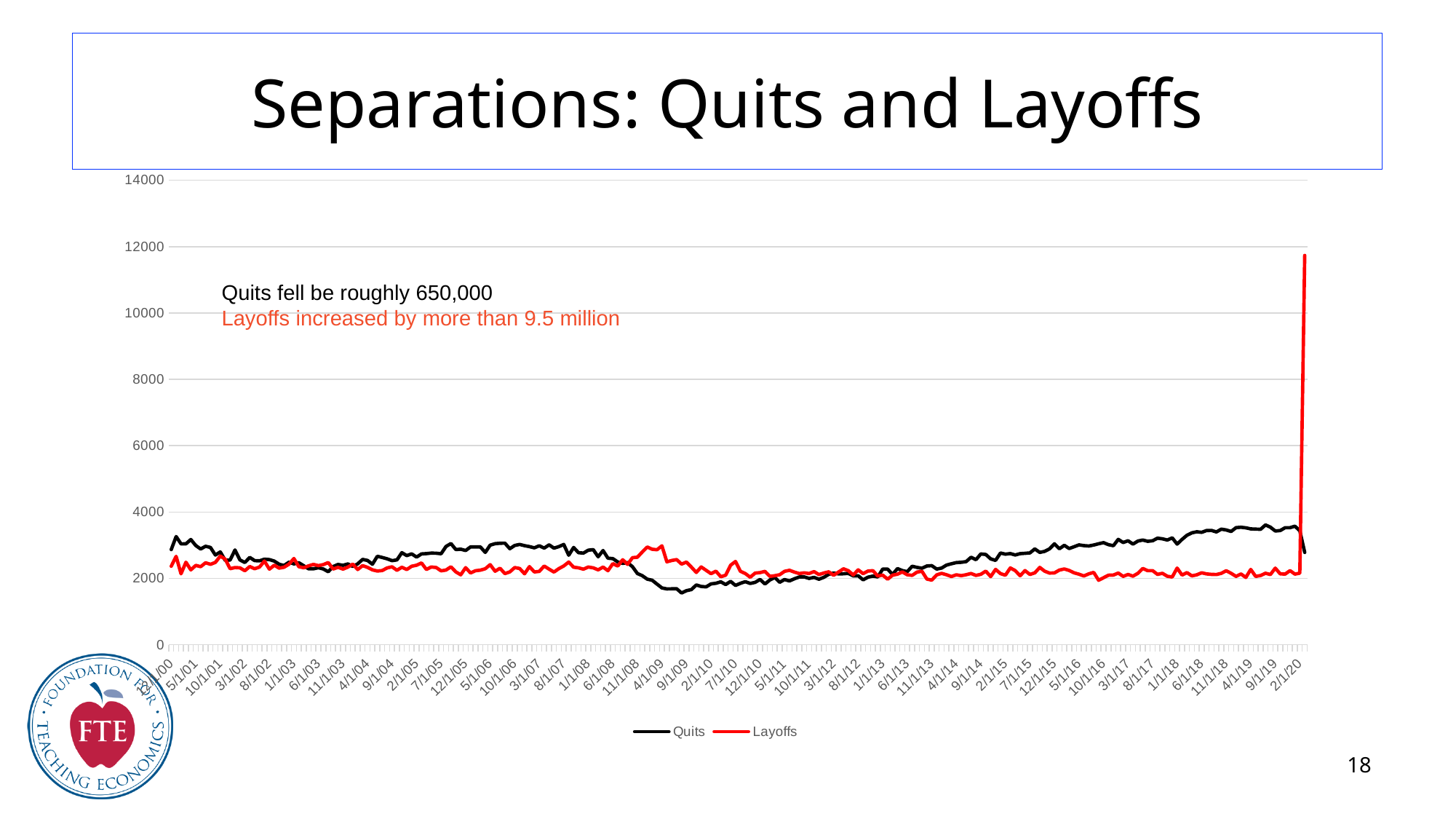
Is the value of Quits around 9/1/19 greater or less than 3000? greater What are the two series named in the legend? Quits and Layoffs At the final data point on the chart, which series has the larger value, Quits or Layoffs? Layoffs What kind of chart is shown on the slide? line chart Does the Quits series generally rise or fall between 4/1/14 and 9/1/19? rise Is the value of Quits around 9/1/09 greater or less than 2000? less What is the title of the slide containing the chart? Separations: Quits and Layoffs Is the peak value of the Layoffs series greater or less than 10000? greater Around 9/1/19, which series has the larger value, Quits or Layoffs? Quits How many series does the legend list? 2 Around 4/1/09, which series has the larger value, Quits or Layoffs? Layoffs Which series reaches the highest value on the chart? Layoffs